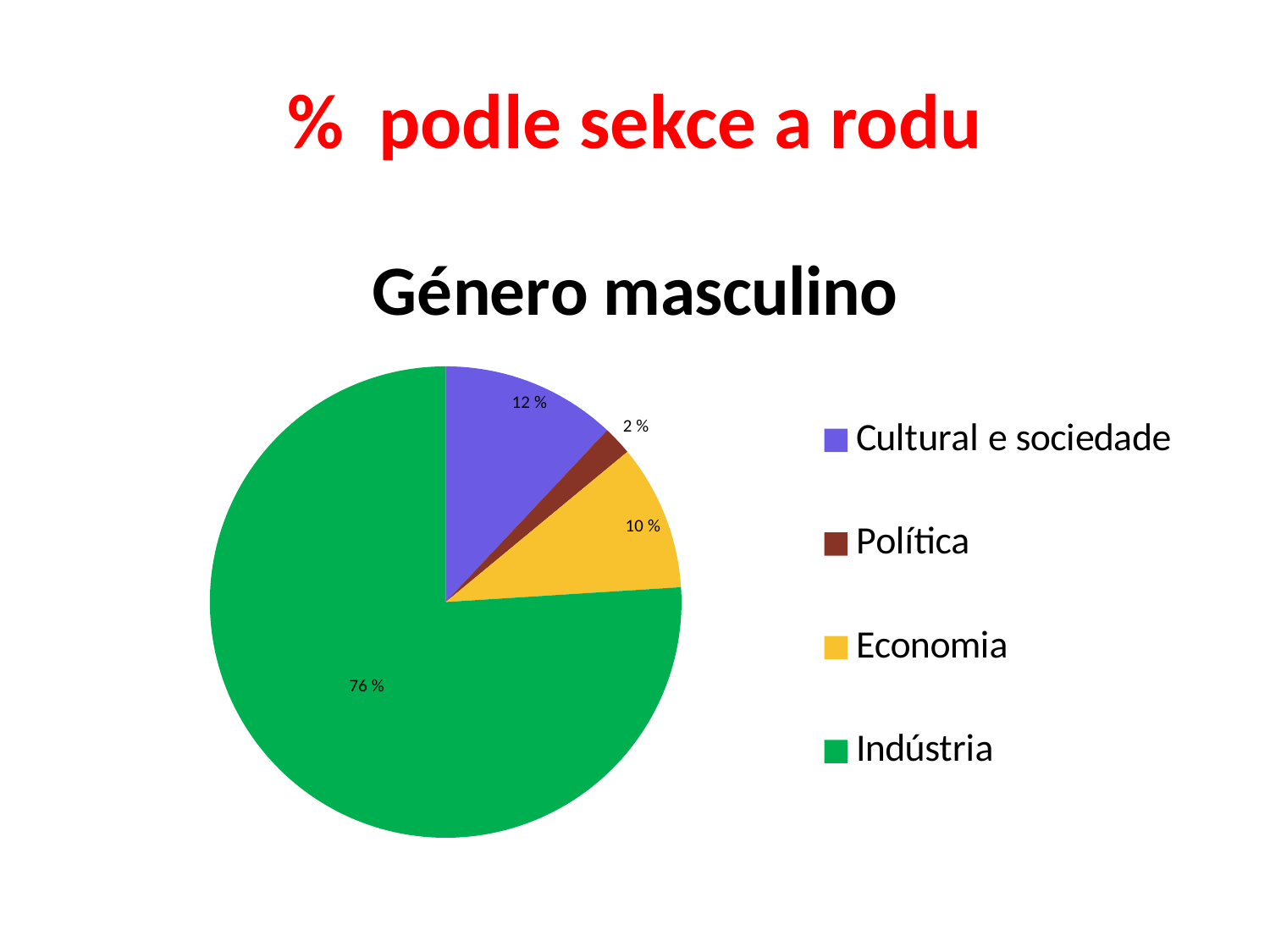
How many categories does the legend list? 4 What percentage does the Política slice show? 2 % Which is larger, the Cultural e sociedade slice or the Economia slice? Cultural e sociedade What type of chart is shown on the slide? pie chart Which category has the smallest slice of the pie? Política What is the title of the chart? Género masculino Which category has the largest slice of the pie? Indústria What percentage does the Cultural e sociedade slice show? 12 % What is the difference in percentage points between Indústria and Cultural e sociedade? 64 What colour is the Economia slice? yellow What percentage does the Indústria slice show? 76 % What percentage does the Economia slice show? 10 %